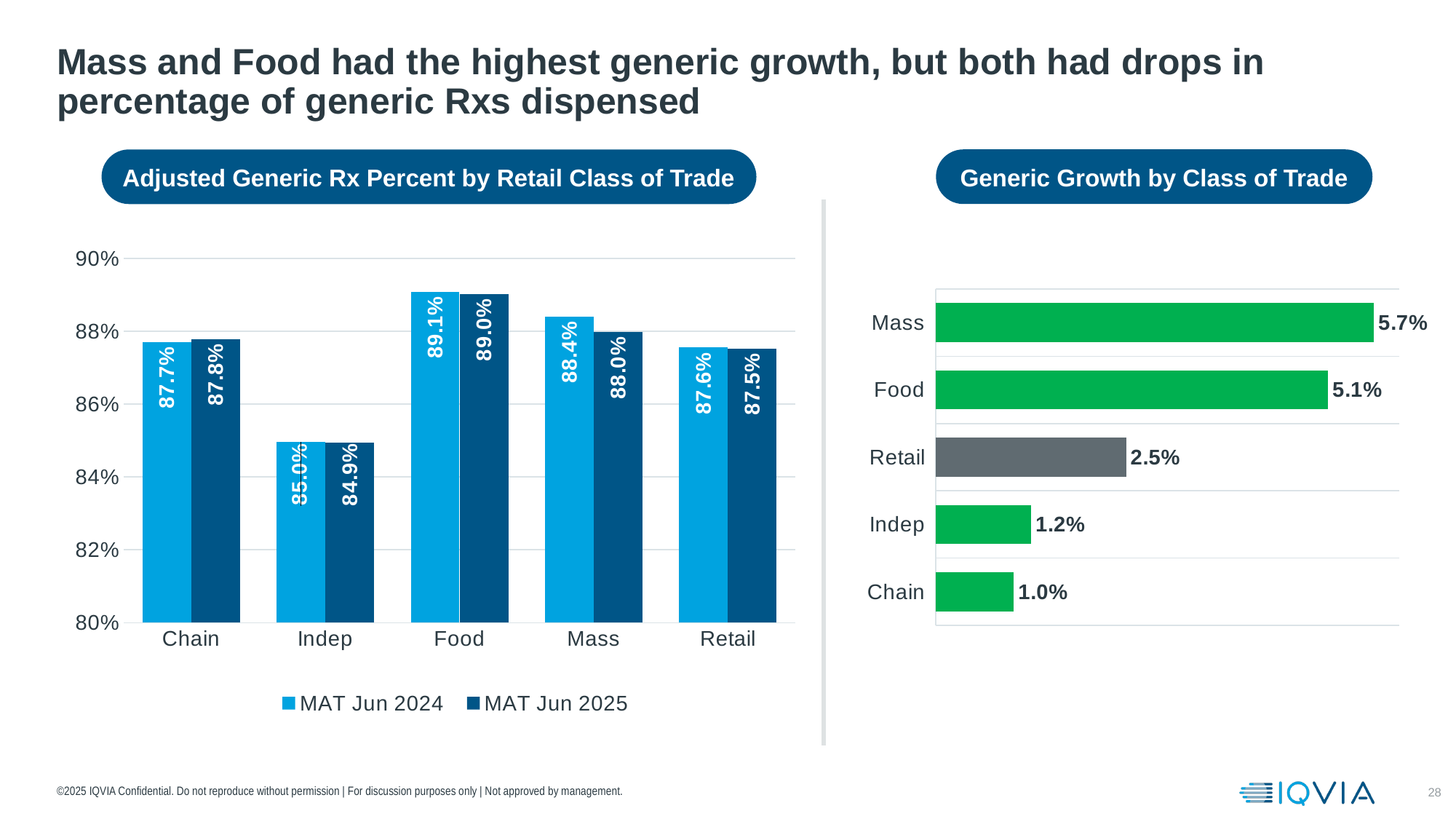
In the 'Generic Growth by Class of Trade' chart, which class of trade has the highest generic growth? Mass In the 'Adjusted Generic Rx Percent by Retail Class of Trade' chart, how many classes of trade are shown on the x axis? 5 In the 'Generic Growth by Class of Trade' chart, what is the value for Retail? 2.5% In the 'Adjusted Generic Rx Percent by Retail Class of Trade' chart, how many series does the legend list? 2 In the 'Generic Growth by Class of Trade' chart, which class of trade has the lowest generic growth? Chain What kind of chart is the 'Generic Growth by Class of Trade' chart? Bar chart In the 'Generic Growth by Class of Trade' chart, what is the difference between the values for Mass and Food? 0.6% In the 'Adjusted Generic Rx Percent by Retail Class of Trade' chart, which class of trade has the highest MAT Jun 2024 value? Food In the 'Adjusted Generic Rx Percent by Retail Class of Trade' chart, what is the MAT Jun 2024 value for Indep? 85.0% In the 'Adjusted Generic Rx Percent by Retail Class of Trade' chart, what is the MAT Jun 2025 value for Food? 89.0% In the 'Adjusted Generic Rx Percent by Retail Class of Trade' chart, which class of trade has the lowest MAT Jun 2025 value? Indep In the 'Adjusted Generic Rx Percent by Retail Class of Trade' chart, what is the difference between the MAT Jun 2024 and MAT Jun 2025 values for Mass? 0.4%